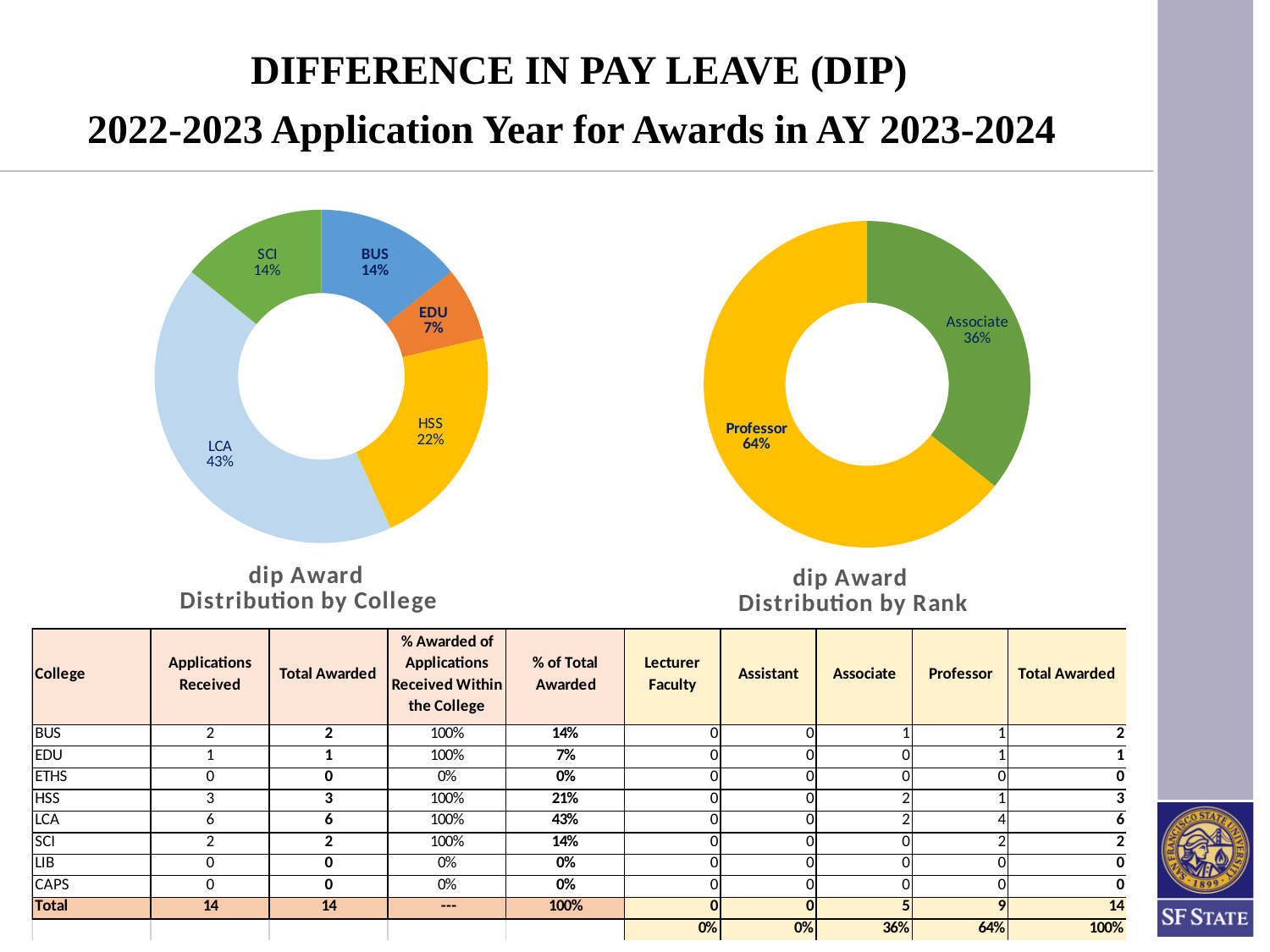
In the 'dip Award Distribution by College' chart, which is larger, the share for HSS or the share for SCI? HSS In the 'dip Award Distribution by College' chart, what share is shown for HSS? 22% In the 'dip Award Distribution by Rank' chart, what share is shown for Associate? 36% In the 'dip Award Distribution by College' chart, what is the difference between the LCA share and the HSS share? 21% What kind of chart is the 'dip Award Distribution by Rank' chart? Donut (pie) chart In the 'dip Award Distribution by College' chart, what share is shown for LCA? 43% In the 'dip Award Distribution by Rank' chart, what share is shown for Professor? 64% In the 'dip Award Distribution by College' chart, which college has the largest share? LCA In the 'dip Award Distribution by College' chart, what share is shown for EDU? 7% In the 'dip Award Distribution by College' chart, which college has the smallest share? EDU In the 'dip Award Distribution by College' chart, how many colleges are shown as slices? 5 In the 'dip Award Distribution by Rank' chart, how many rank categories are shown? 2